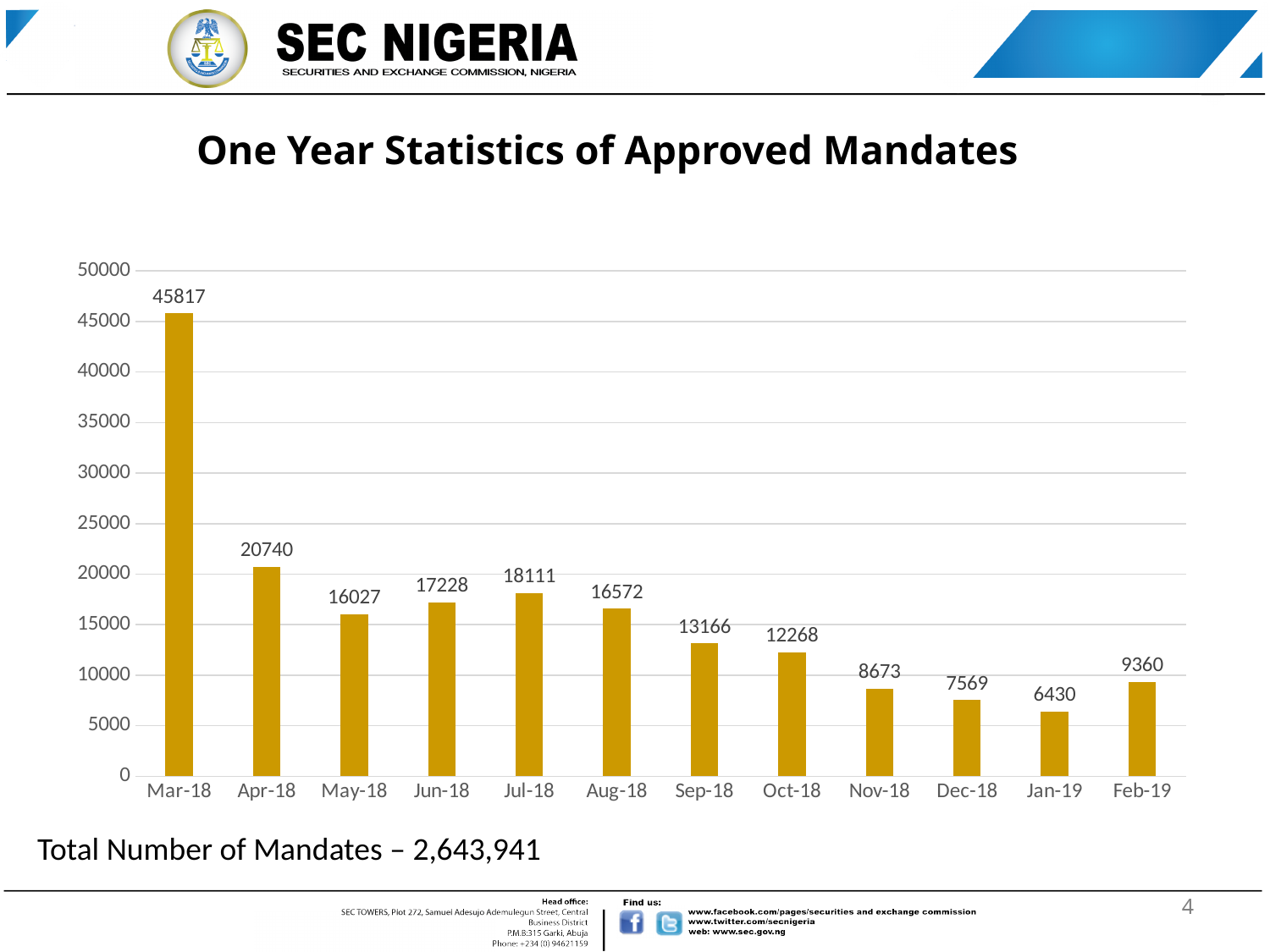
What is the value for Mar-18? 45817 How many months are shown on the x axis? 12 Is the value for Sep-18 greater or less than 15000? less Which month has the highest value? Mar-18 Do the values generally rise or fall from Mar-18 to Jan-19? fall What is the value for Feb-19? 9360 What is the title of the chart? One Year Statistics of Approved Mandates What is the value for Jul-18? 18111 Which month has the lowest value? Jan-19 What is the difference between the values for Apr-18 and May-18? 4713 What kind of chart is shown on the slide? bar chart Which is larger, the value for Jun-18 or the value for Aug-18? Jun-18